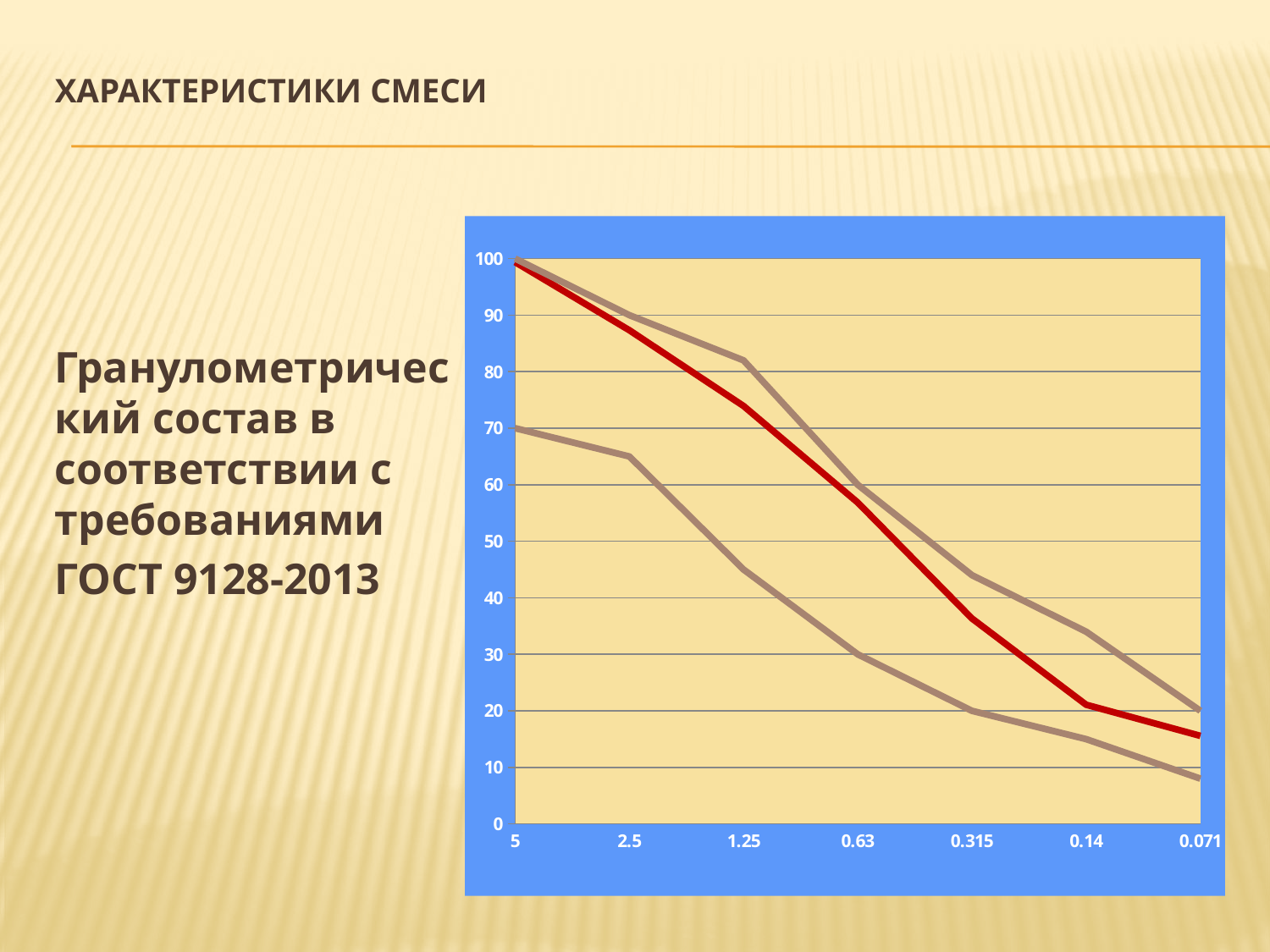
What is the value of the upper brown line at 5? 100 At 0.63, which is larger: the red line or the lower brown line? the red line Do the values of the red line rise or fall from left to right along the x axis? fall What is the value of the upper brown line at 0.071? 20 What is the value of the lower brown line at 5? 70 Is the value of the red line at 0.63 greater or less than 50? greater Is the value of the lower brown line at 1.25 greater or less than 50? less At which x-axis point does the red line reach its lowest value? 0.071 What kind of chart is shown on the slide? line chart How many points are marked along the x axis of the chart? 7 What colour is the middle line on the chart? red How many lines are plotted on the chart? 3